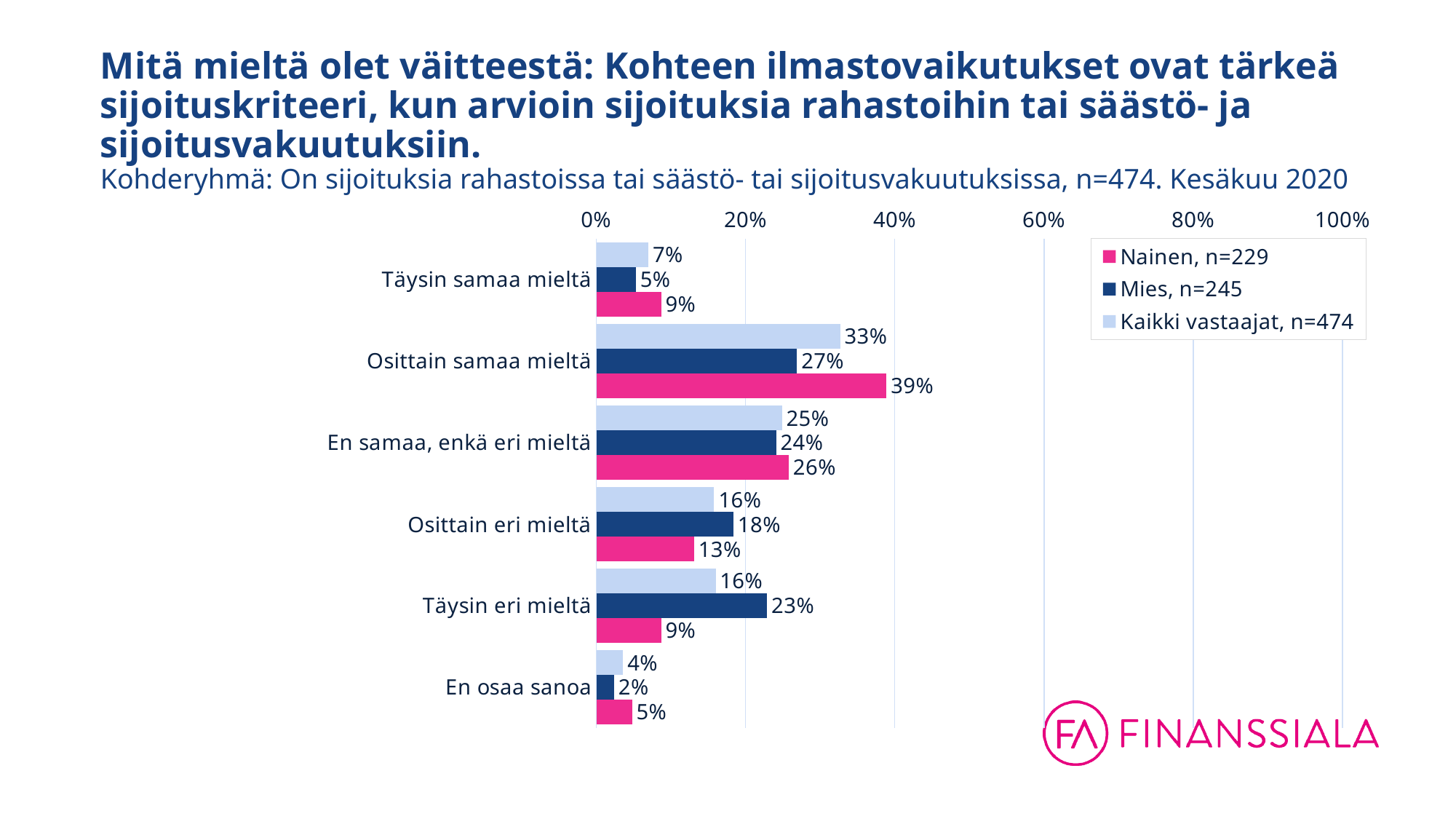
Which is larger in the Täysin eri mieltä category: the value for Nainen, n=229 or for Mies, n=245? Mies, n=245 What is the value for Kaikki vastaajat, n=474 in the En samaa, enkä eri mieltä category? 25% What is the value for Mies, n=245 in the Täysin eri mieltä category? 23% How many series does the legend list? 3 Which category has the highest value for Kaikki vastaajat, n=474? Osittain samaa mieltä What is the sample size given in the legend for Kaikki vastaajat? n=474 What kind of chart is shown on the slide? bar chart Is the value for Nainen, n=229 in the Osittain samaa mieltä category greater or less than 20%? greater What is the value for Nainen, n=229 in the Osittain samaa mieltä category? 39% What is the difference between the Nainen, n=229 and Mies, n=245 values in the Osittain samaa mieltä category? 12% How many categories are shown on the y axis of the chart? 6 Which category has the lowest value for Mies, n=245? En osaa sanoa